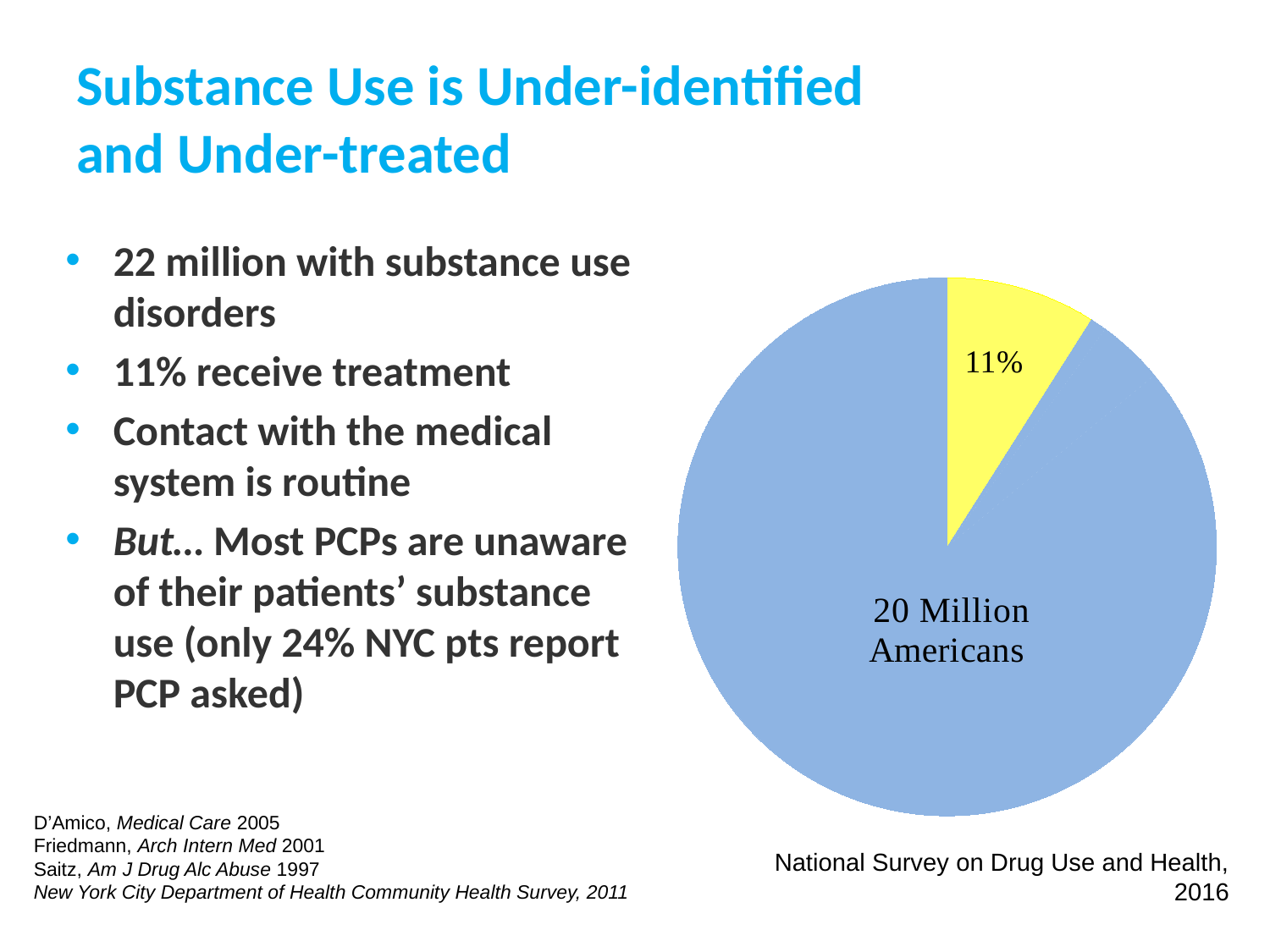
What colour is the slice labeled 11% in the pie chart? yellow Which slice of the pie chart is larger, the one labeled 11% or the one labeled 20 Million Americans? 20 Million Americans Which slice of the pie chart is the smallest? 11% What kind of chart is shown on the slide? pie chart What share of the pie does the yellow slice represent? 11% What is the label on the large blue slice of the pie chart? 20 Million Americans Which slice of the pie chart is the largest? 20 Million Americans What source is cited beneath the pie chart? National Survey on Drug Use and Health, 2016